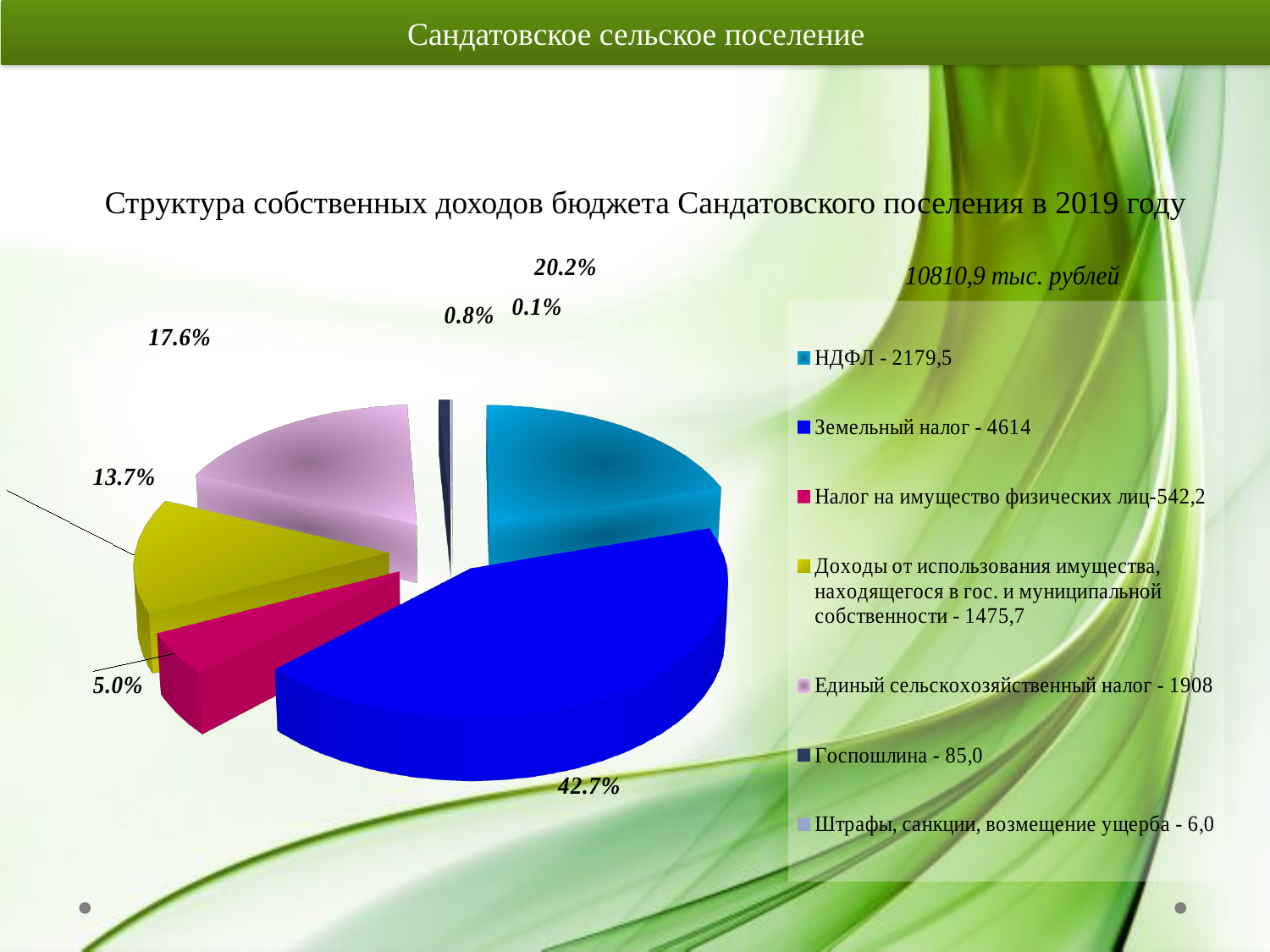
What share of the pie does Земельный налог take? 42.7% What value is given in the legend for Налог на имущество физических лиц? 542,2 What kind of chart is shown on the slide? pie chart Which is larger: the value for Единый сельскохозяйственный налог or the value for Доходы от использования имущества, находящегося в гос. и муниципальной собственности? Единый сельскохозяйственный налог What total amount is shown above the legend of the chart? 10810,9 тыс. рублей What value is given in the legend for Госпошлина? 85,0 What is the difference between the legend values for Земельный налог and НДФЛ? 2434,5 What share of the pie does НДФЛ take? 20.2% What share of the pie does Единый сельскохозяйственный налог take? 17.6% Which category has the largest share of the pie? Земельный налог How many categories does the legend of the pie chart list? 7 Which category has the smallest share of the pie? Штрафы, санкции, возмещение ущерба